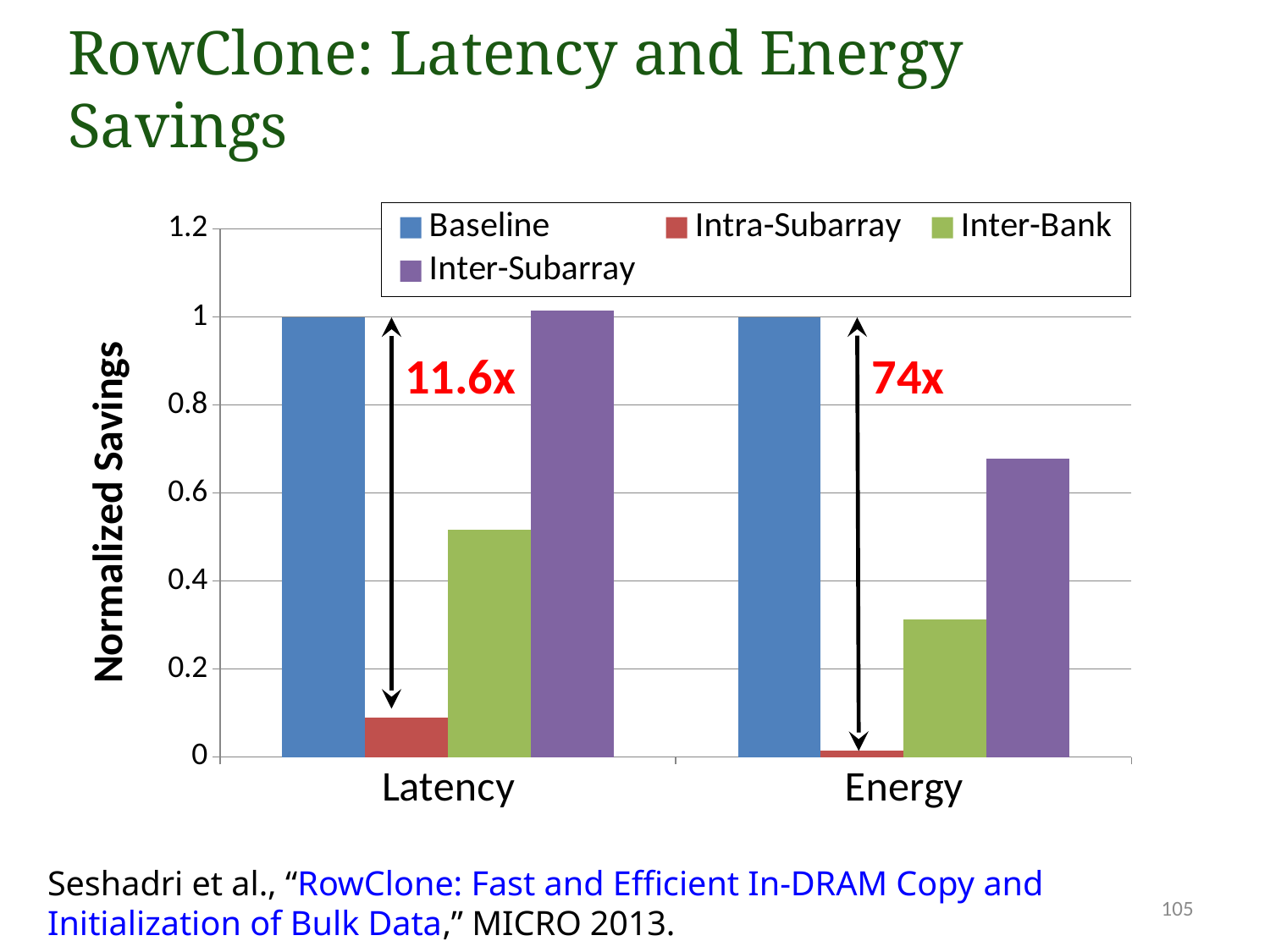
What is the Baseline value for Energy? 1 Which is larger: the Inter-Bank value for Latency or the Inter-Bank value for Energy? Latency Is the Intra-Subarray value for Latency greater or less than 0.2? less Is the Inter-Subarray value for Energy greater or less than 0.8? less Which series has the highest value for Energy? Baseline Is the Inter-Bank value for Latency greater or less than 0.4? greater How many series does the legend list? 4 What kind of chart is shown on the slide? bar chart Which series has the lowest value for Latency? Intra-Subarray How many categories are shown on the x axis? 2 What is the Baseline value for Latency? 1 What is the title of the y axis? Normalized Savings